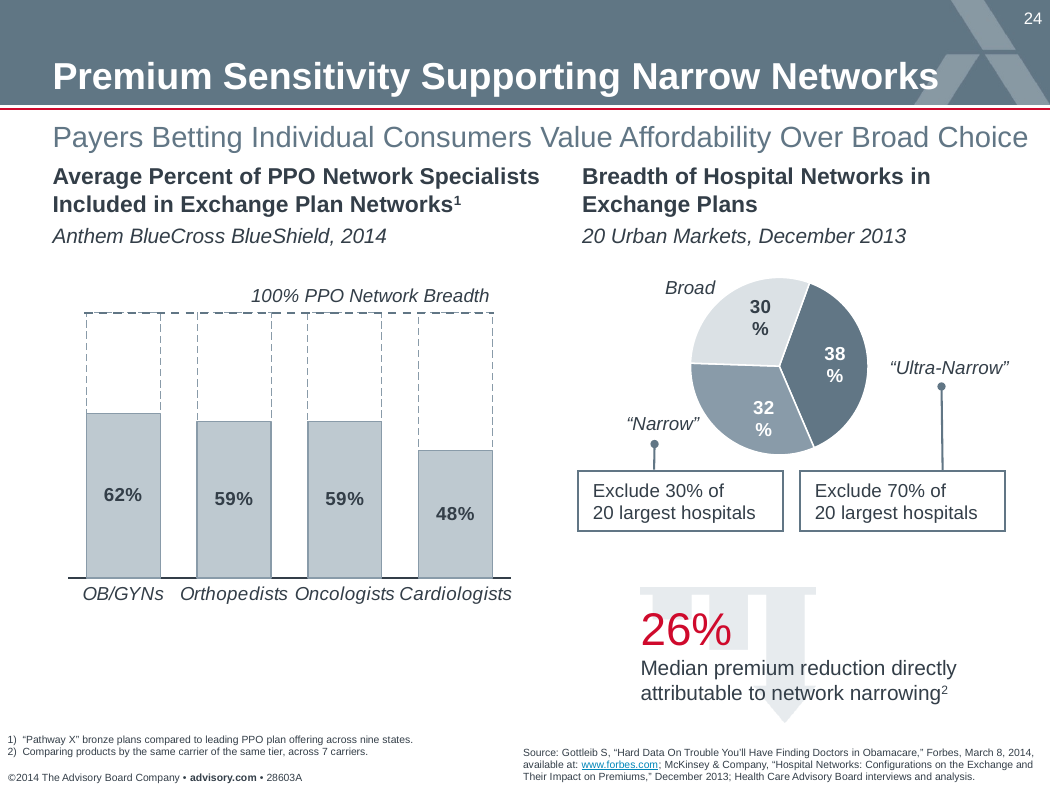
In the bar chart on the left, which specialty has the lowest value? Cardiologists In the bar chart on the left, how many specialty categories are shown? 4 In the pie chart on the right, which category has the largest slice? "Ultra-Narrow" What kind of chart is the one on the right showing breadth of hospital networks? Pie chart In the bar chart on the left, what is the value for Cardiologists? 48% In the bar chart on the left, do the values rise or fall from OB/GYNs to Cardiologists? Fall In the pie chart on the right, what share is labeled "Ultra-Narrow"? 38% In the pie chart on the right, what share is labeled Broad? 30% In the bar chart on the left, what is the value for OB/GYNs? 62% In the bar chart on the left, which specialty has the highest value? OB/GYNs What kind of chart is the one on the left showing PPO network specialists? Bar chart In the bar chart on the left, what is the difference between the values for OB/GYNs and Cardiologists? 14%